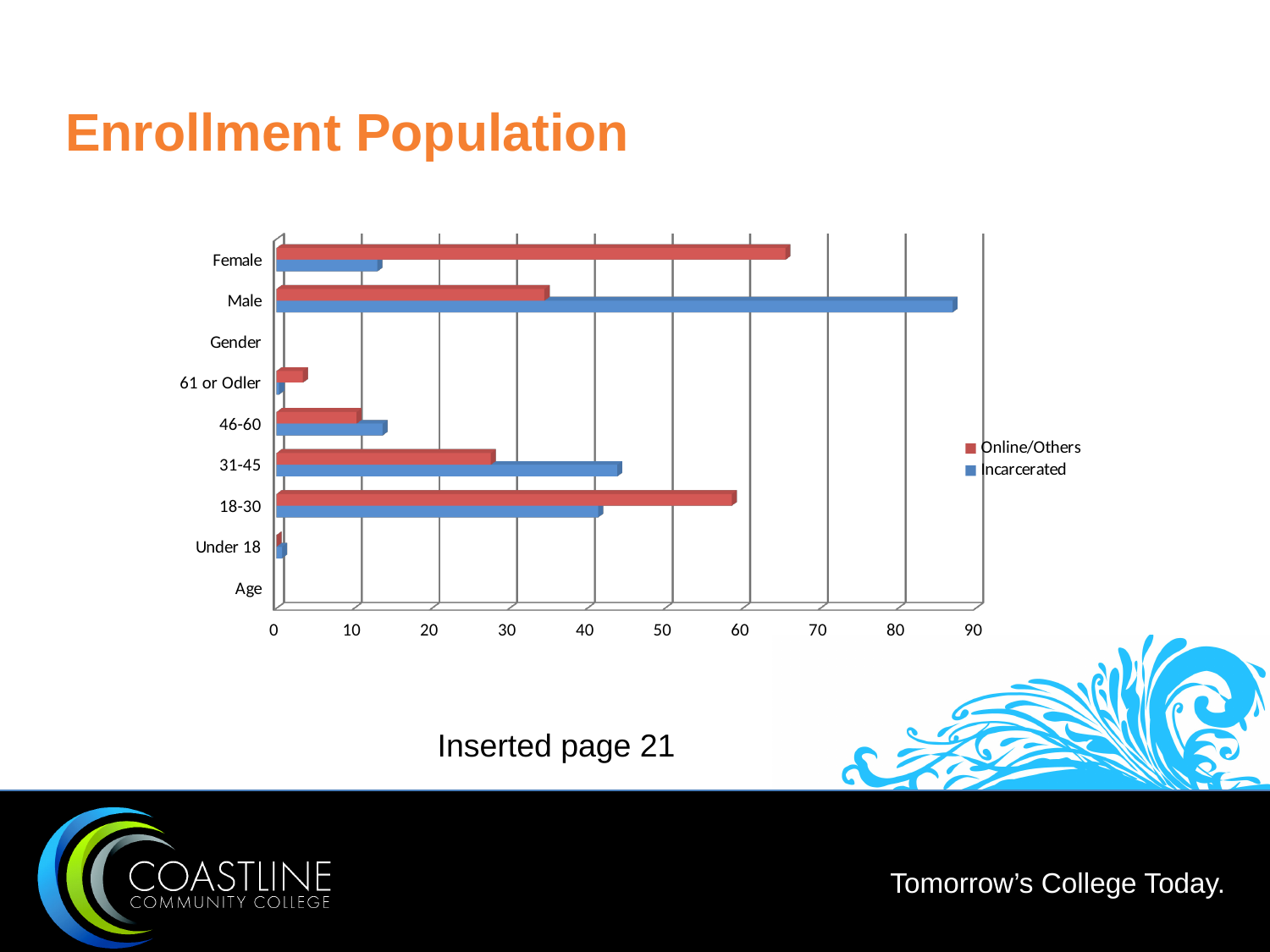
For Female, which series has the larger value, Online/Others or Incarcerated? Online/Others Which category has the highest Incarcerated value? Male For 18-30, which series has the larger value, Online/Others or Incarcerated? Online/Others Is the Online/Others value for 46-60 greater or less than 20? less How many series does the legend list? 2 Is the Online/Others value for Female greater or less than 60? greater Which category has the highest Online/Others value? Female Which colour represents the Incarcerated series? blue What type of chart is shown on the slide? bar chart For Male, which series has the larger value, Online/Others or Incarcerated? Incarcerated Is the Incarcerated value for Male greater or less than 80? greater What are the two series named in the legend? Online/Others and Incarcerated